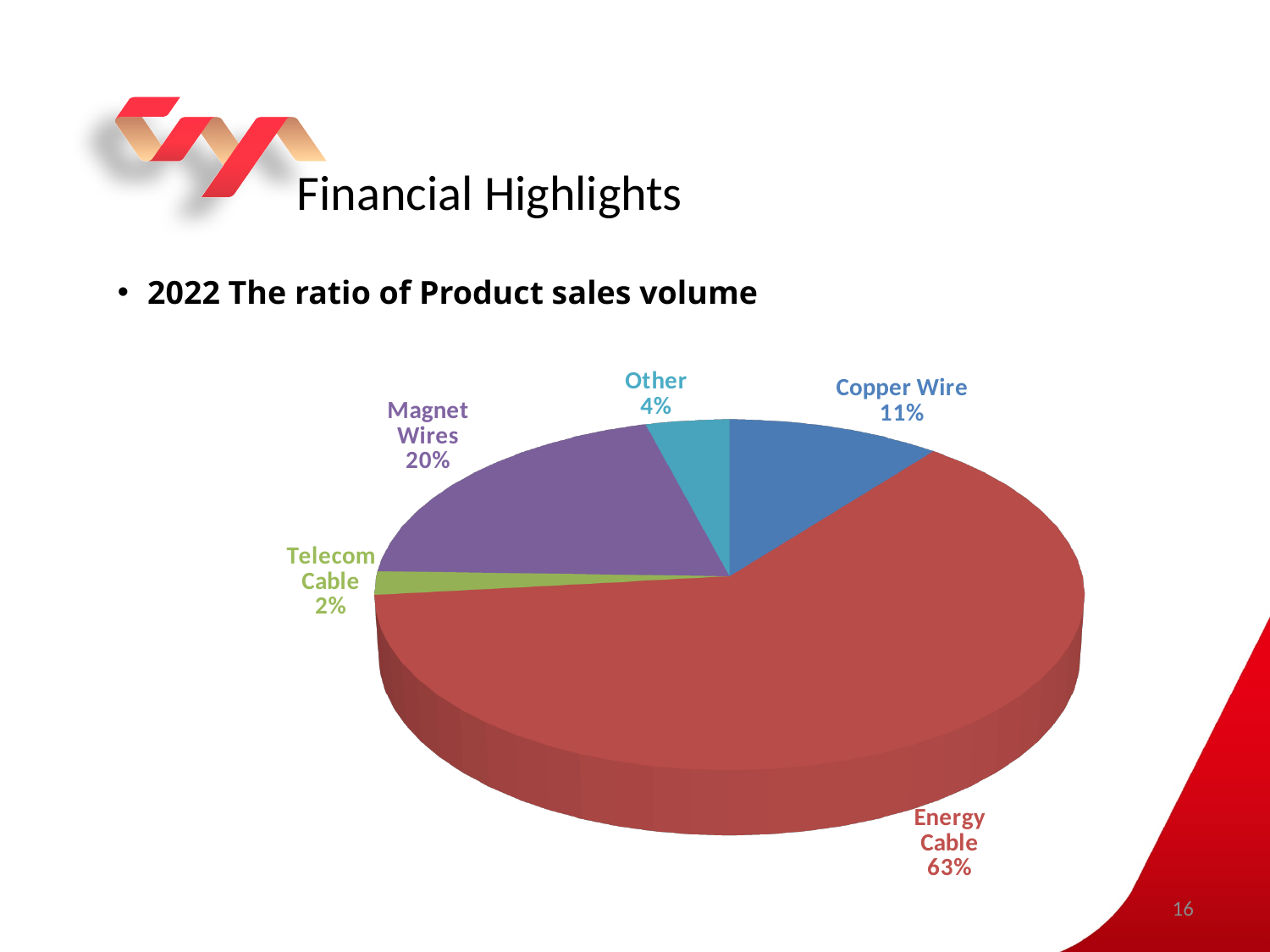
What percentage of the pie is Magnet Wires? 20% What share does the Other slice represent? 4% Which product category has the largest share of sales volume? Energy Cable Which is larger, the share for Copper Wire or the share for Other? Copper Wire What percentage is shown for Telecom Cable? 2% How many product categories are shown in the pie chart? 5 What kind of chart is shown on the slide? Pie chart What is the difference in percentage points between Energy Cable and Magnet Wires? 43 What is the value shown for Copper Wire? 11% What share of product sales volume does Energy Cable account for? 63% Which product category has the smallest share of sales volume? Telecom Cable What colour is the Energy Cable slice? Red